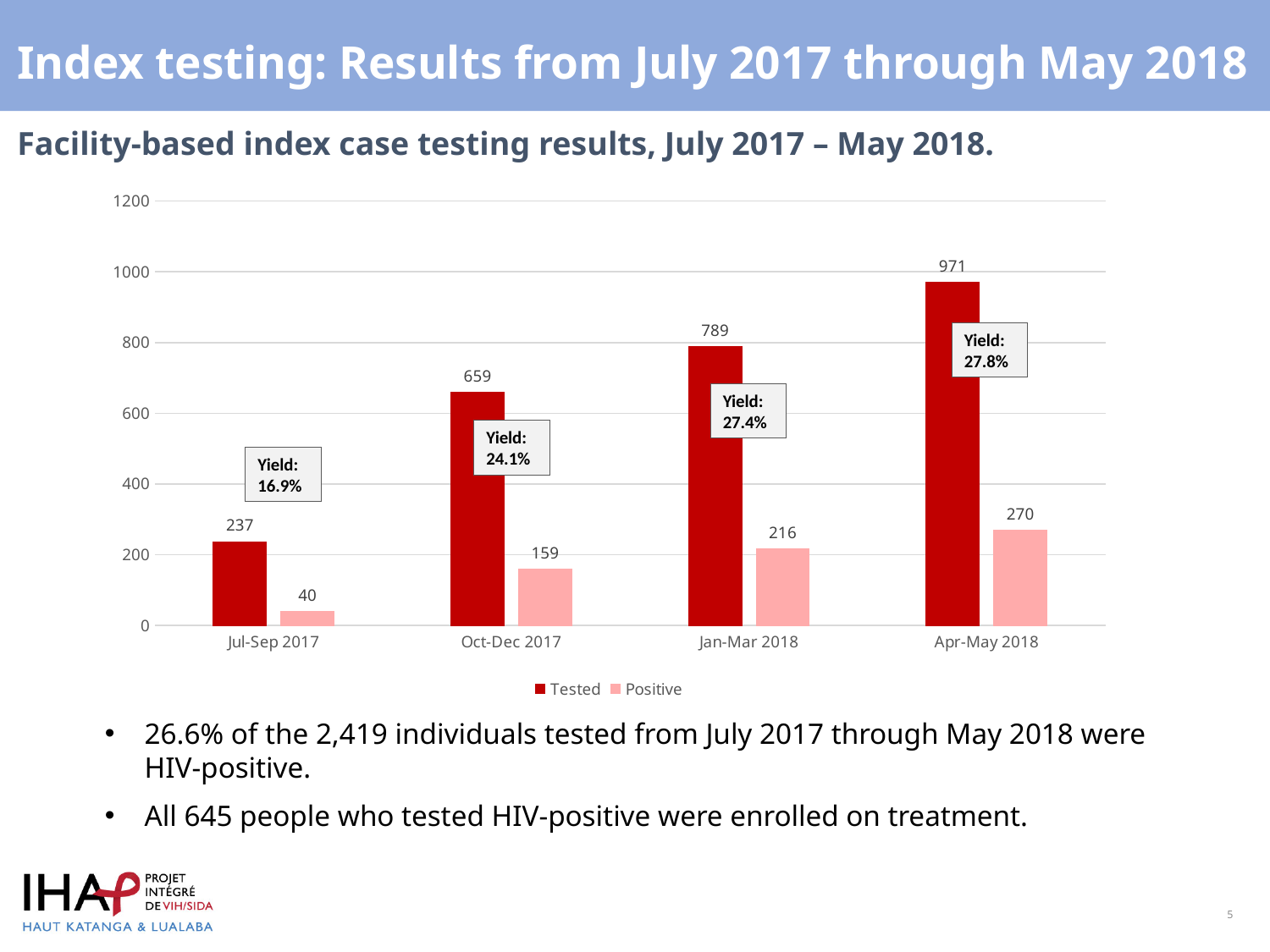
What kind of chart is shown? Bar chart How many people tested positive in Apr-May 2018? 270 Which period has the highest number tested? Apr-May 2018 How many series does the legend list? 2 What is the difference between the number tested in Oct-Dec 2017 and the number positive in that period? 500 How many time periods are shown on the x axis? 4 How many individuals were tested in Jul-Sep 2017? 237 Which period has the lowest number of positives? Jul-Sep 2017 Is the Tested value for Apr-May 2018 greater or less than 1000? less Does the number tested rise or fall from Jul-Sep 2017 to Apr-May 2018? Rise Which is larger: the number positive in Jan-Mar 2018 or the number positive in Oct-Dec 2017? Jan-Mar 2018 What is the Tested value for Jan-Mar 2018? 789